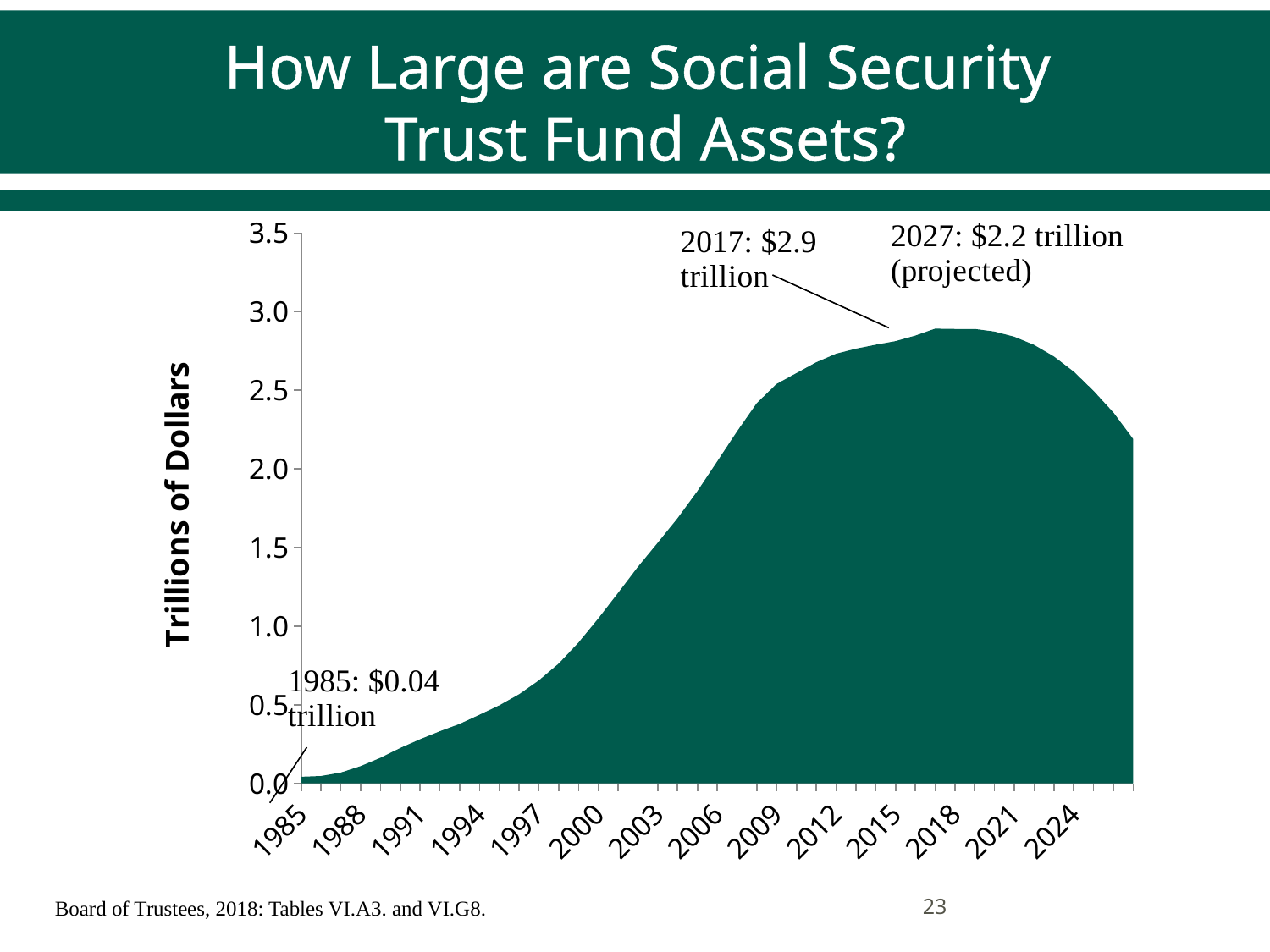
Is the value for 1991 greater or less than 0.5 trillion dollars? less What is the difference between the 2017 value and the projected 2027 value? $0.7 trillion Is the value for 2009 greater or less than 2.0 trillion dollars? greater What is the value of trust fund assets in 1985 according to the chart annotation? $0.04 trillion Is the value for 1997 greater or less than 1.0 trillion dollars? less Which year has the larger trust fund assets, 2017 or 2027? 2017 What is the projected value of trust fund assets in 2027? $2.2 trillion What is the value of Social Security Trust Fund assets in 2017 according to the chart annotation? $2.9 trillion What kind of chart is shown on the slide? Area chart Do trust fund assets rise or fall between 2018 and 2027? Fall Do trust fund assets rise or fall between 1985 and 2017? Rise What is the label on the vertical axis of the chart? Trillions of Dollars